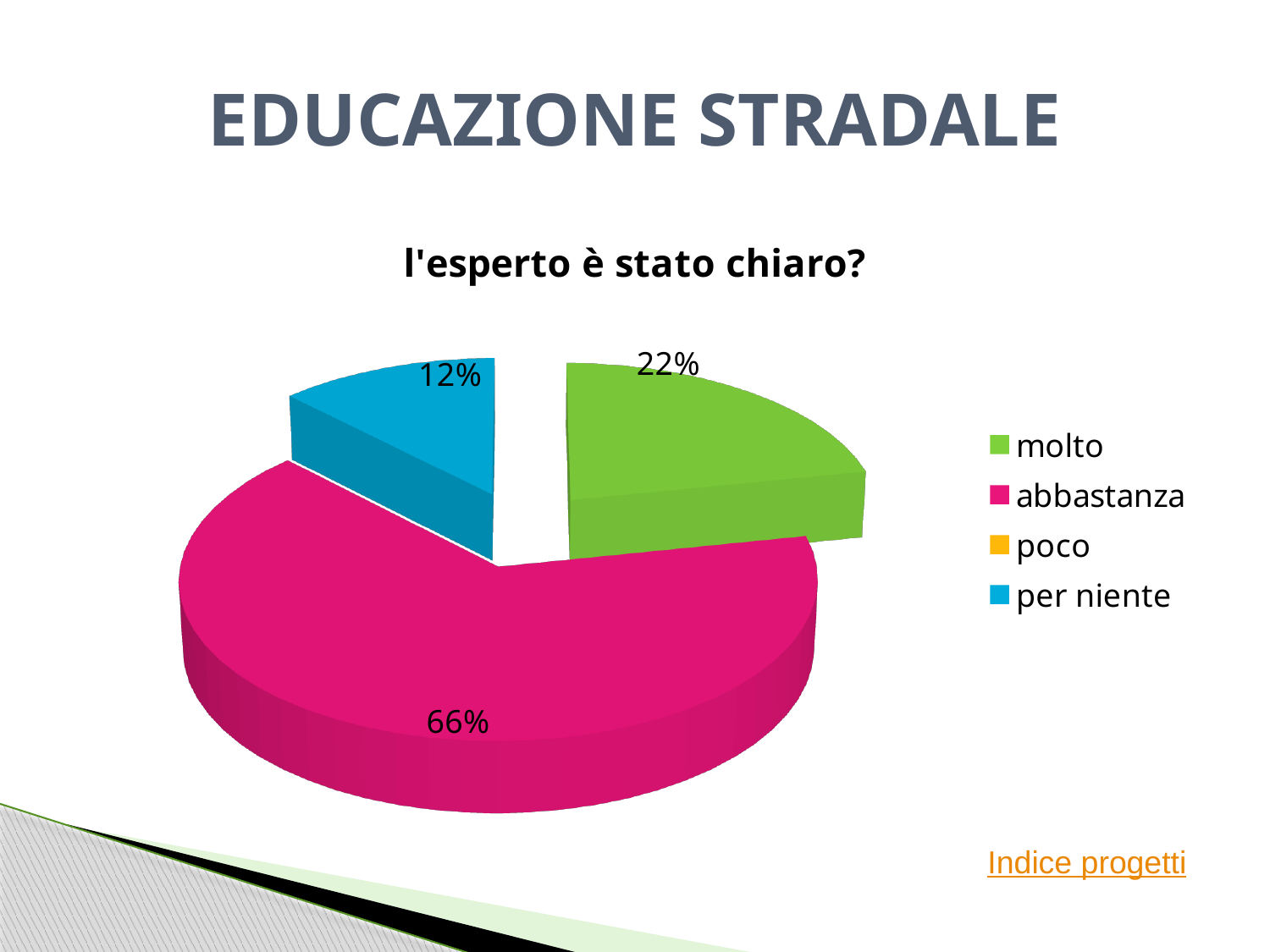
How many entries does the legend list? 4 Which category has the largest slice of the pie? abbastanza What percentage of the pie is labelled for "per niente"? 12% What kind of chart is shown on the slide? pie chart Which of the labelled slices is the smallest? per niente What percentage of the pie is labelled for "molto"? 22% What is the difference in percentage points between the "abbastanza" slice and the "molto" slice? 44 What is the chart's title? l'esperto è stato chiaro? What colour is the slice for "abbastanza"? magenta Which is larger, the slice for "molto" or the slice for "per niente"? molto What is the combined share of the "molto" and "per niente" slices? 34% What percentage of the pie is labelled for "abbastanza"? 66%